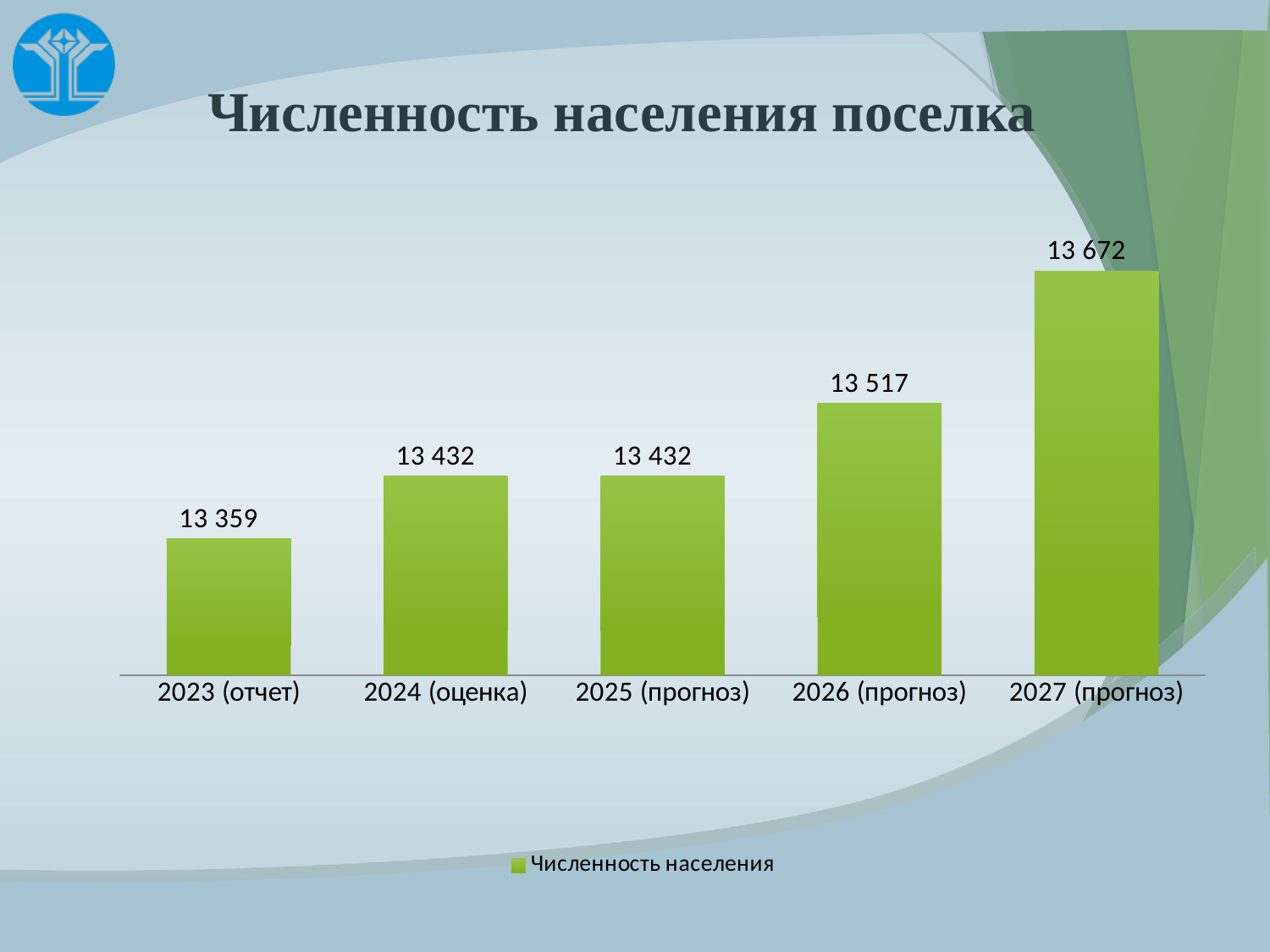
Which year has the highest population value? 2027 (прогноз) How many series does the legend list? 1 What is the population value for 2027 (прогноз)? 13 672 What is the title of the chart? Численность населения поселка What is the population value for 2023 (отчет)? 13 359 What is the difference between the values for 2027 (прогноз) and 2026 (прогноз)? 155 What is the population value for 2026 (прогноз)? 13 517 What kind of chart is shown on the slide? bar chart Which is larger, the value for 2025 (прогноз) or the value for 2026 (прогноз)? 2026 (прогноз) How many years (categories) are shown on the chart? 5 What is the difference between the values for 2024 (оценка) and 2023 (отчет)? 73 Which year has the lowest population value? 2023 (отчет)